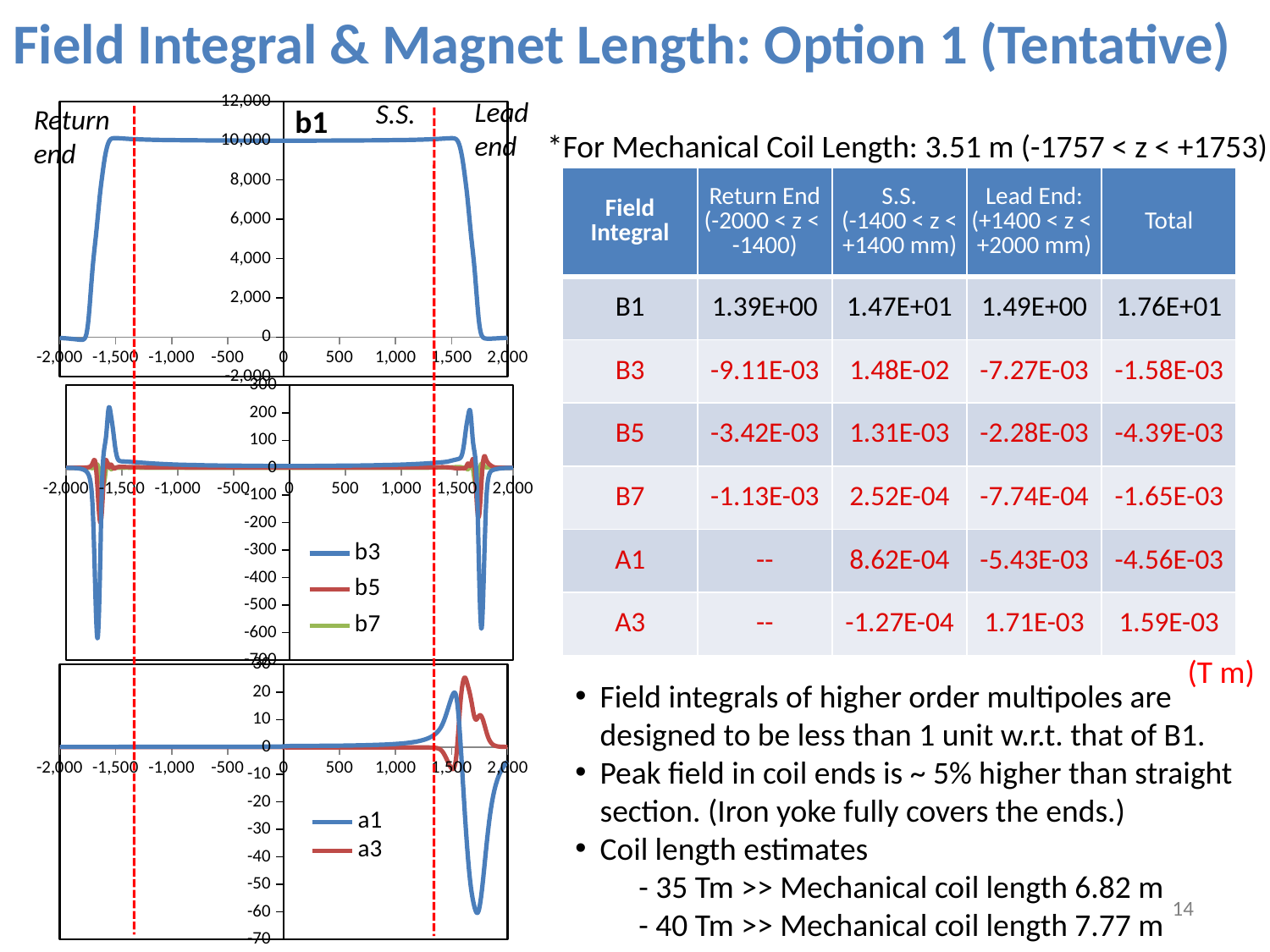
In the bottom chart, how many series does the legend list? 2 In the middle chart, what are the legend entries? b3, b5, b7 In the bottom chart, is the lowest value of a1 greater or less than -40? less In the bottom chart, is the value of a1 at x = -1,000 greater or less than 10? less In the top chart, is the value of b1 at x = -2,000 greater or less than 2,000? less In the middle chart, how many series does the legend list? 3 In the top chart, does the b1 curve rise or fall between x = 1,500 and x = 2,000? fall In the bottom chart, what are the legend entries? a1, a3 What kind of chart is the top chart labelled b1? line chart How many charts are shown on the slide? 3